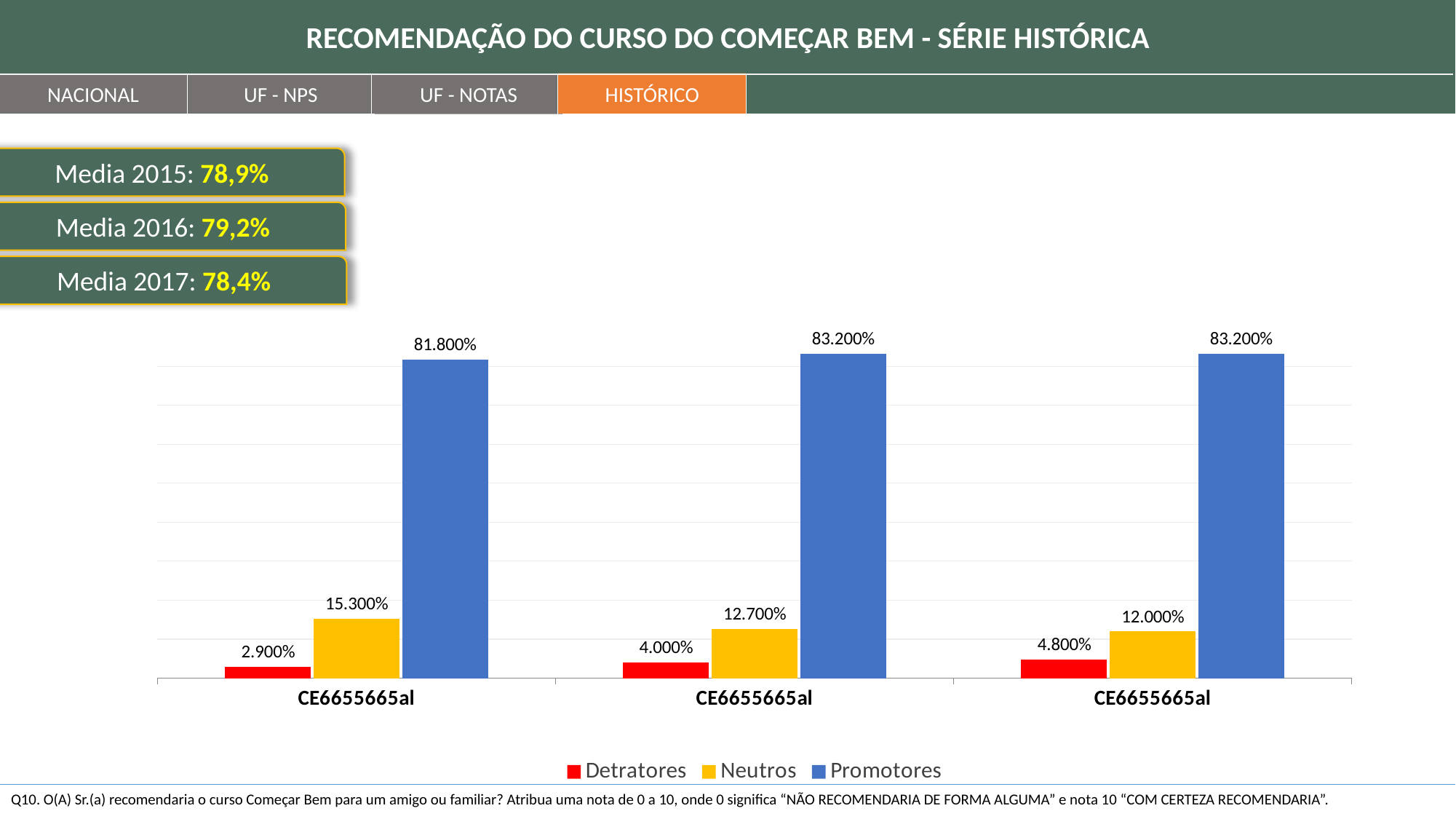
What is the difference between the Neutros values of the leftmost and rightmost groups of bars? 3.300% Do the Detratores values rise or fall from left to right across the groups? rise What is the Detratores value for the rightmost group of bars? 4.800% What is the Neutros value for the leftmost group of bars? 15.300% Is the Detratores value larger in the leftmost group or the rightmost group of bars? rightmost group How many groups of bars are plotted along the x axis? 3 What kind of chart is shown on the slide? bar chart Which series has the lowest value in the leftmost group of bars? Detratores How many series does the chart legend list? 3 Which series has the highest value in the middle group of bars? Promotores What is the Promotores value for the leftmost group of bars? 81.800% What is the Neutros value for the middle group of bars? 12.700%